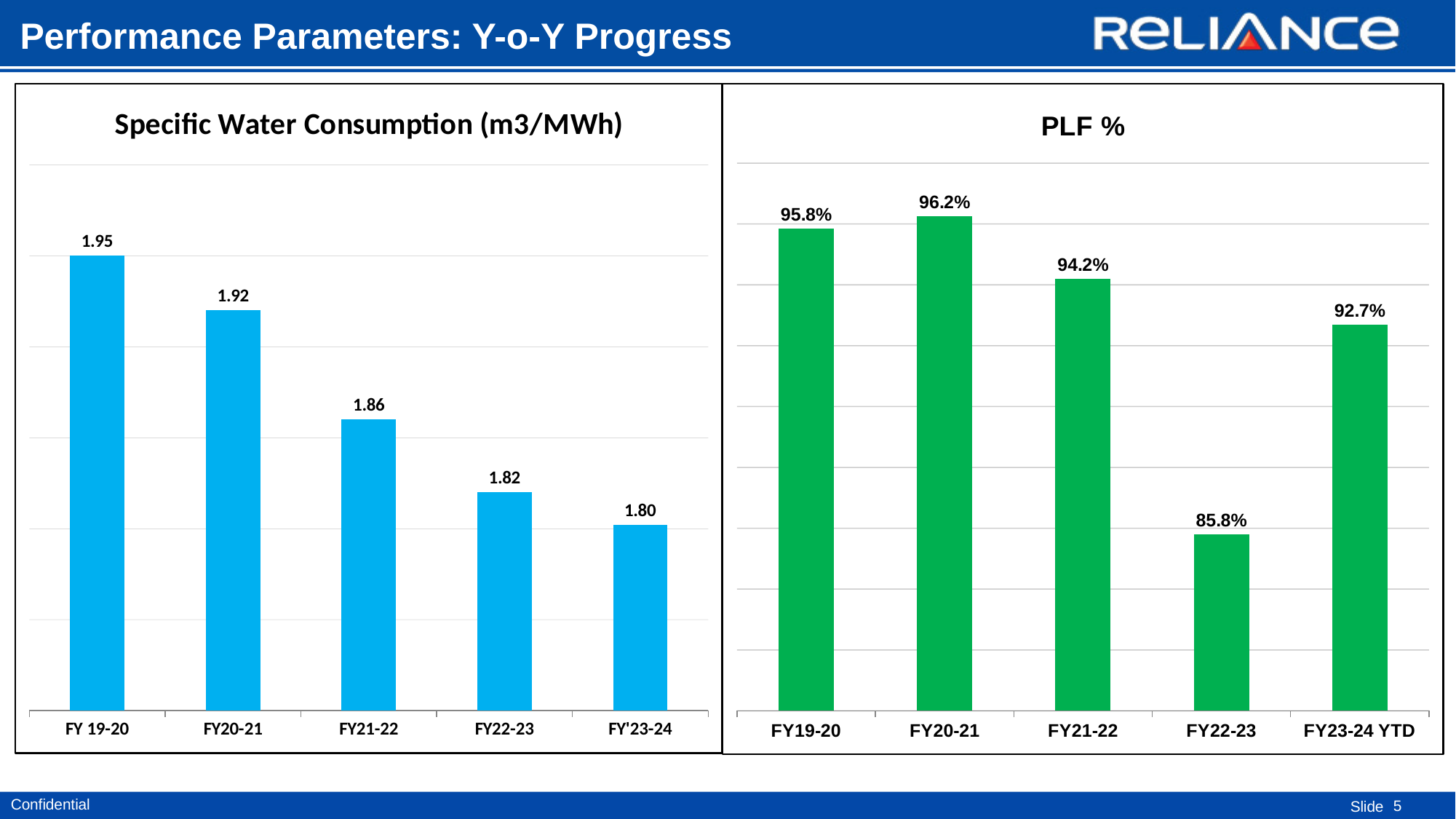
In the PLF % chart, what is the difference between the FY20-21 and FY22-23 values? 10.4% In the Specific Water Consumption (m3/MWh) chart, what is the value for FY21-22? 1.86 In the Specific Water Consumption (m3/MWh) chart, which fiscal year has the highest value? FY 19-20 In the Specific Water Consumption (m3/MWh) chart, which fiscal year has the lowest value? FY'23-24 In the PLF % chart, which fiscal year has the highest value? FY20-21 In the PLF % chart, which fiscal year has the lowest value? FY22-23 In the PLF % chart, which is larger, the value for FY21-22 or the value for FY23-24 YTD? FY21-22 In the PLF % chart, what is the value for FY22-23? 85.8% In the Specific Water Consumption (m3/MWh) chart, what is the difference between the FY 19-20 and FY'23-24 values? 0.15 In the Specific Water Consumption (m3/MWh) chart, how many fiscal years are plotted? 5 In the Specific Water Consumption (m3/MWh) chart, do the values rise or fall from FY 19-20 to FY'23-24? fall What type of chart is the PLF % chart? bar chart